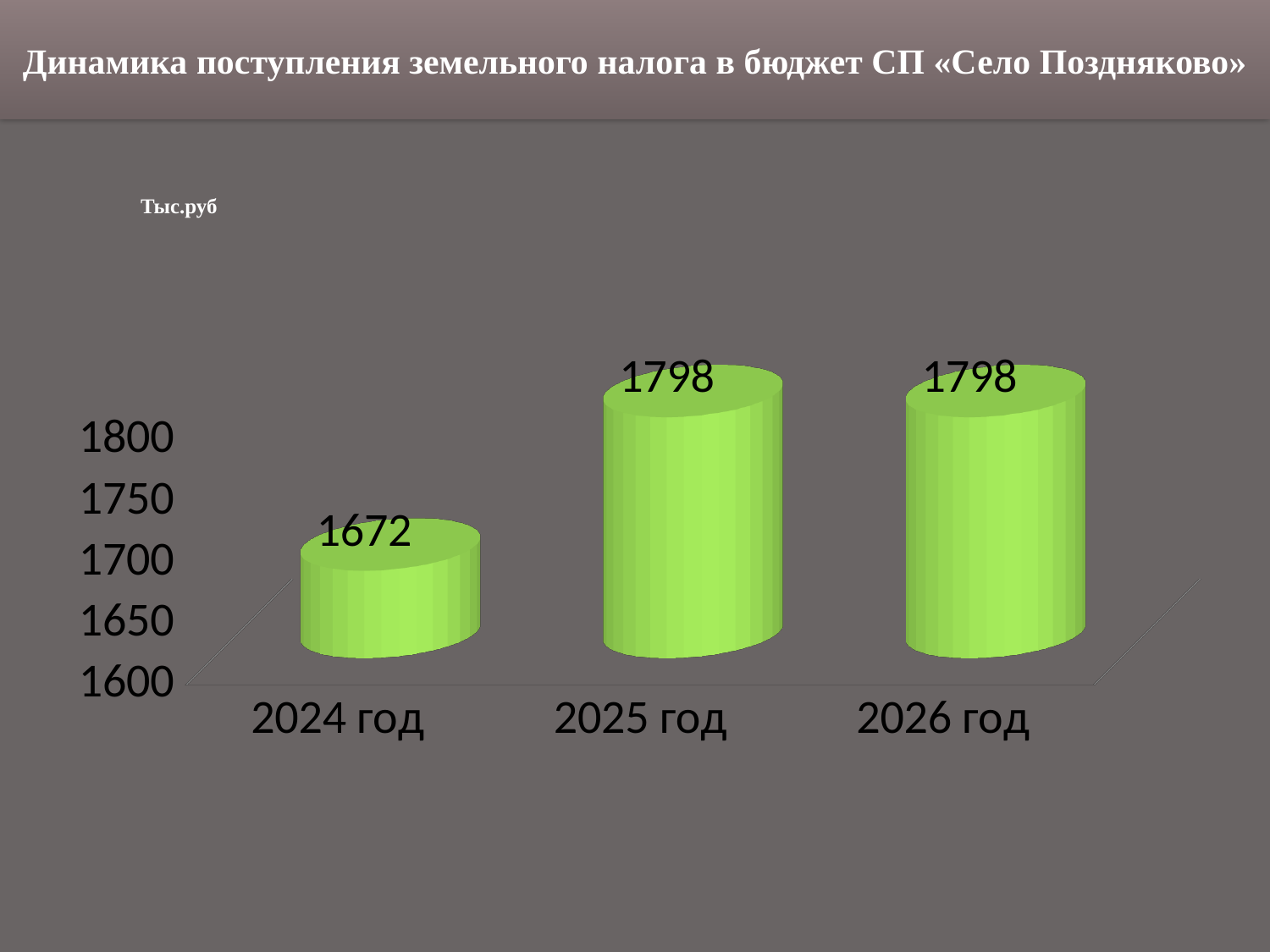
Is the value for 2024 год greater or less than 1700? less Which year has the lowest value? 2024 год What is the value for 2025 год? 1798 What is the difference between the values for 2025 год and 2024 год? 126 What is the value for 2026 год? 1798 What kind of chart is shown on the slide? bar chart Do the values rise or fall from 2024 год to 2025 год? rise How many years are shown on the chart? 3 Is the value for 2025 год greater or less than 1750? greater What is the value for 2024 год? 1672 What unit is indicated for the values on the chart? Тыс.руб Which is larger, the value for 2024 год or the value for 2026 год? 2026 год